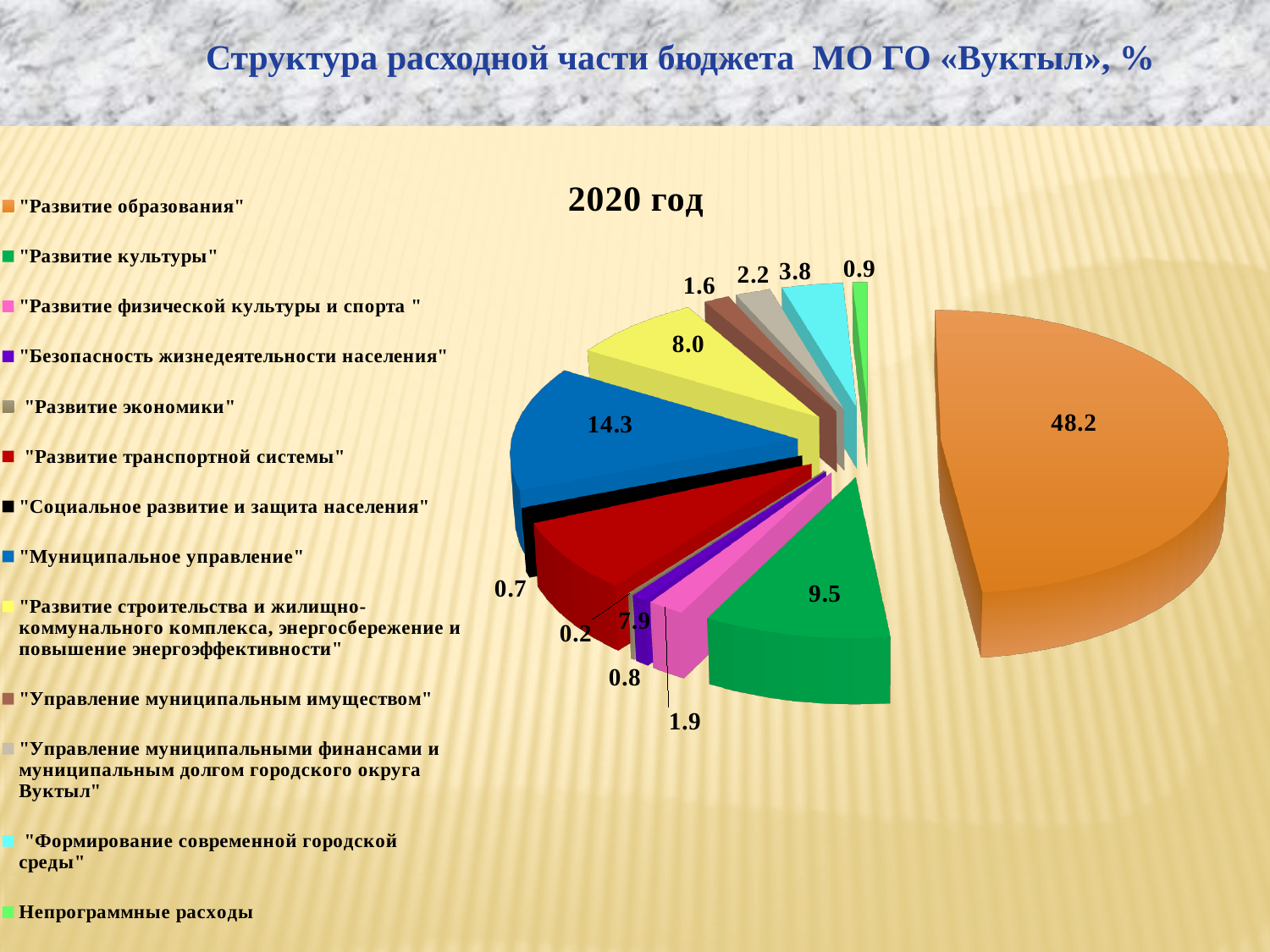
What is the value for "Формирование современной городской среды"? 3.8 What is the title shown above the pie chart? 2020 год How many slices does the pie chart have? 13 What is the value for "Развитие культуры"? 9.5 What is the value for "Муниципальное управление"? 14.3 Which category has the smallest share of the pie? "Развитие экономики" Which is larger, the value for "Развитие культуры" or the value for "Развитие транспортной системы"? "Развитие культуры" What is the difference between the values for "Развитие образования" and "Муниципальное управление"? 33.9 What is the value for "Развитие транспортной системы"? 7.9 What is the value for "Развитие образования"? 48.2 Which category has the largest share of the pie? "Развитие образования" What type of chart is shown on the slide? pie chart